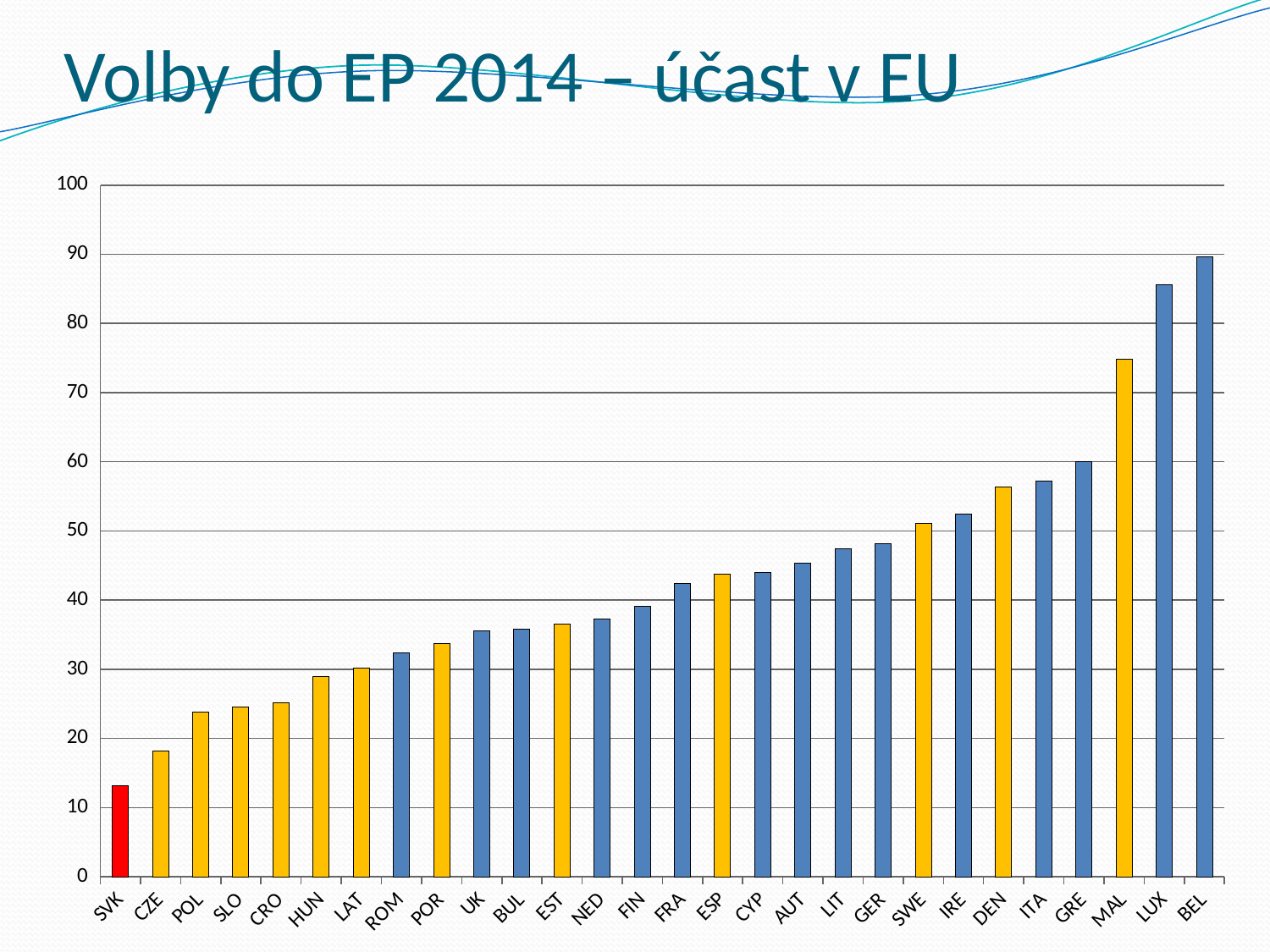
How many countries are shown on the x axis? 28 Which country has the lowest bar? SVK Is the value for LUX greater or less than 80? greater Which is larger, the value for CZE or the value for POL? POL What kind of chart is shown on the slide? bar chart Which country has the highest bar? BEL Is the value for MAL greater or less than 70? greater Which is larger, the value for GRE or the value for DEN? GRE Do the values rise or fall from left to right along the x axis? rise Is the value for SVK greater or less than 20? less What colour is the bar for SVK? red